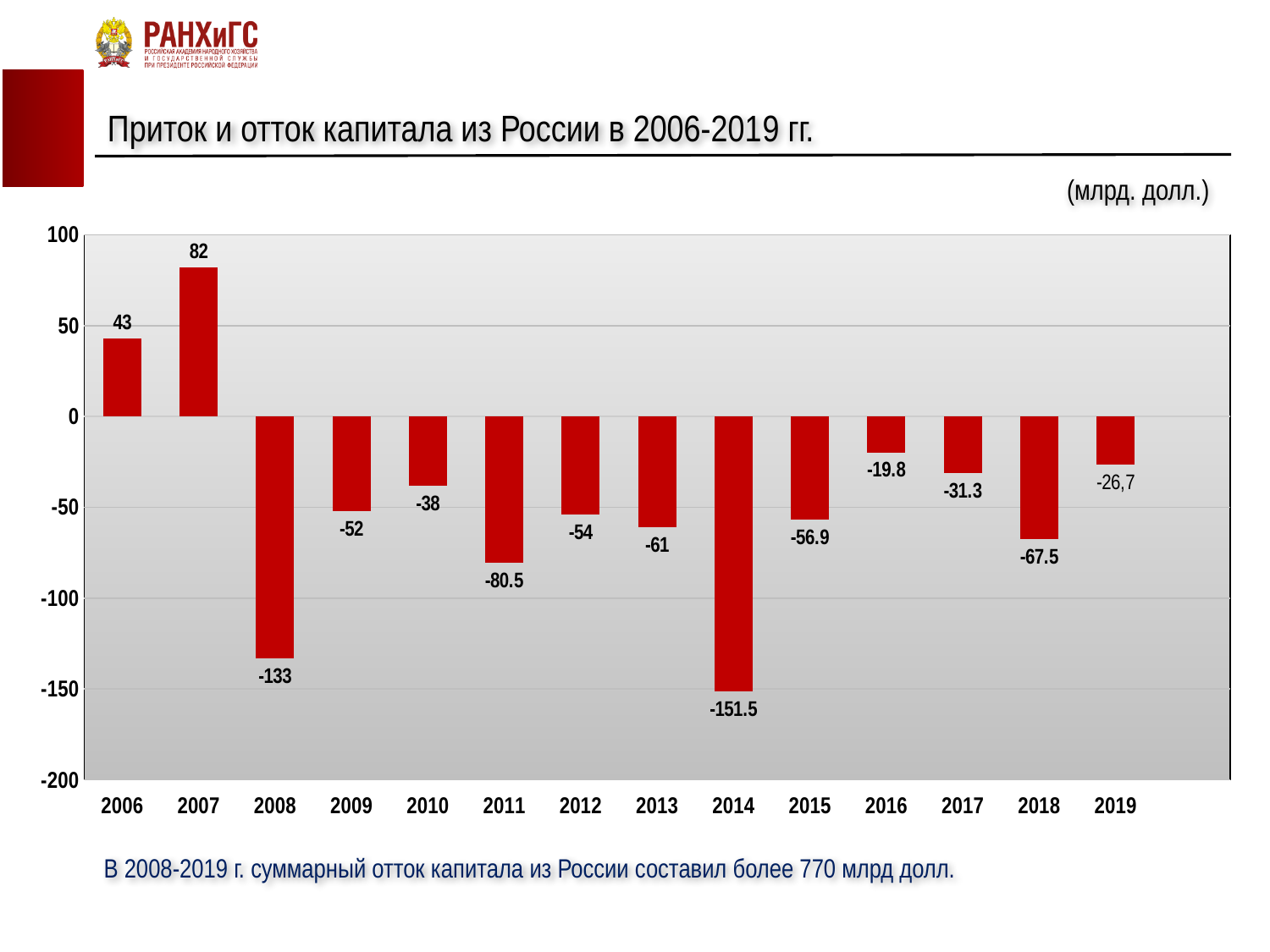
Which year has the highest value? 2007 How many years are shown on the x axis? 14 What is the value for 2014? -151.5 Which is larger, the value for 2016 or the value for 2017? 2016 What is the difference between the values for 2007 and 2006? 39 What is the value for 2007? 82 Which year has the lowest value? 2014 What is the title of the chart? Приток и отток капитала из России в 2006-2019 гг. What kind of chart is shown on the slide? bar chart What is the value for 2019? -26,7 Is the value for 2008 greater or less than -100? less What is the value for 2011? -80.5